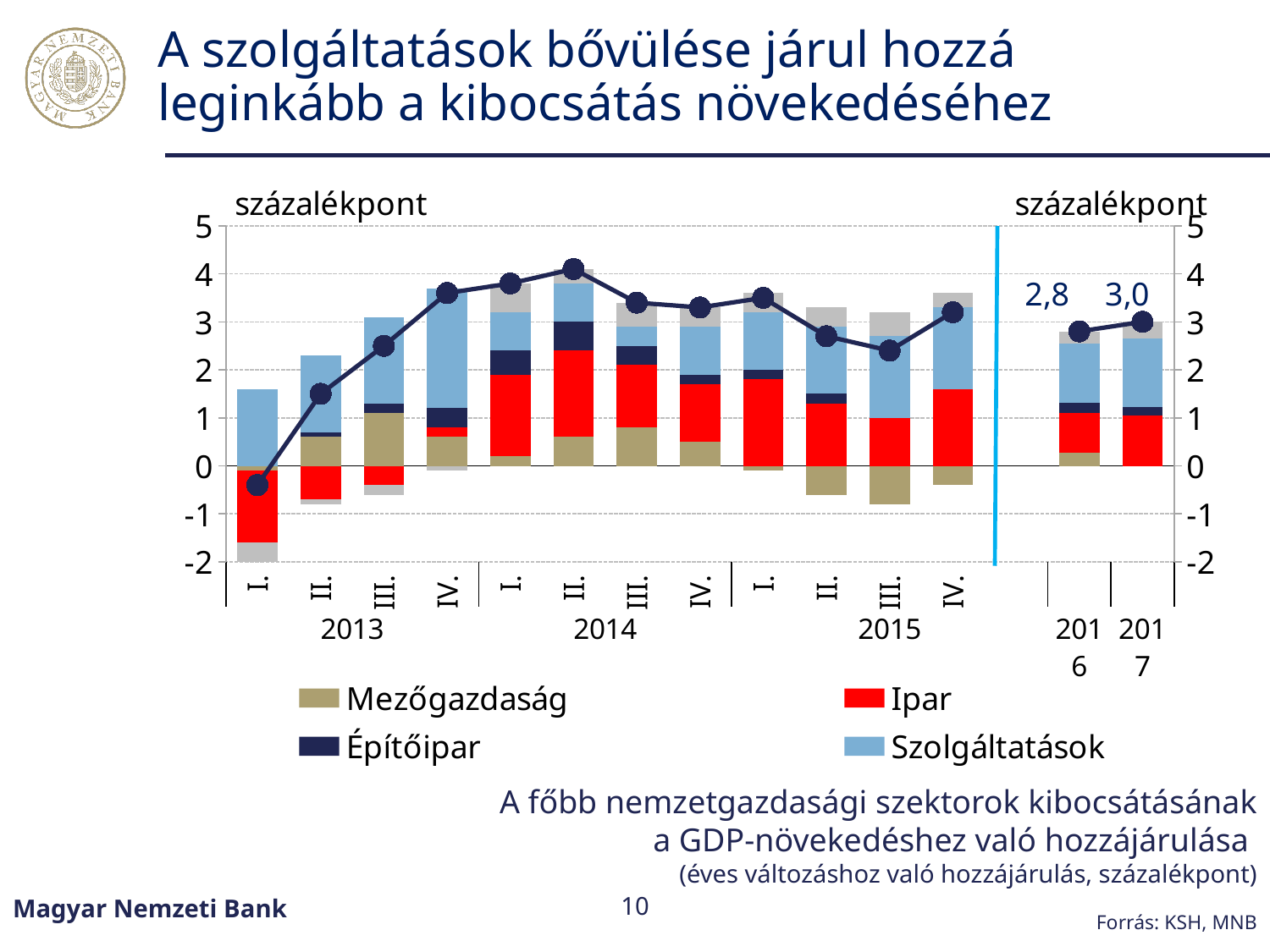
What kind of chart is shown on the slide? Stacked bar chart with a line In which quarter does the line reach its highest value? 2014 II. Is the line value for 2013 I. greater or less than 0? less Which has the larger labelled value, 2016 or 2017? 2017 What is the data label shown for 2017 on the line? 3,0 In which quarter does the line reach its lowest value? 2013 I. What is the difference between the labelled values for 2017 and 2016? 0,2 Does the line rise or fall from 2013 I. to 2014 II.? rise Is the line value for 2014 II. greater or less than 3? greater What is the data label shown for 2016 on the line? 2,8 How many series does the legend list? 4 Is the line value for 2015 III. greater or less than 3? less